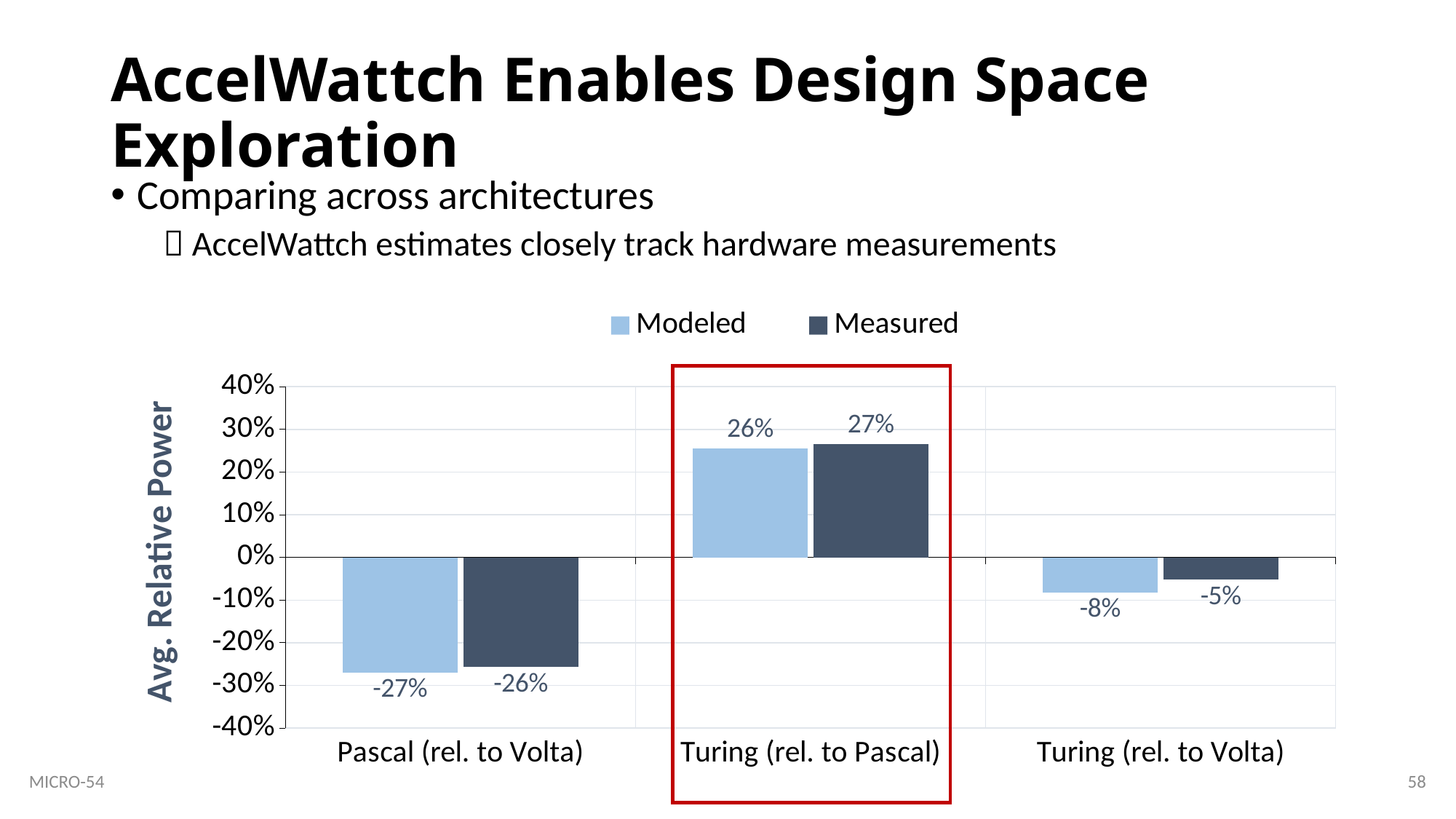
What is the label of the y axis? Avg. Relative Power How many categories are shown on the x axis? 3 What is the Measured value for Turing (rel. to Volta)? -5% What kind of chart is shown on the slide? Bar chart What is the Measured value for Turing (rel. to Pascal)? 27% Which category has the lowest Modeled value? Pascal (rel. to Volta) What is the Modeled value for Pascal (rel. to Volta)? -27% For Pascal (rel. to Volta), which is larger, the Modeled or the Measured value? Measured What is the Modeled value for Turing (rel. to Volta)? -8% Which category has the highest Measured value? Turing (rel. to Pascal) How many series does the legend list? 2 What is the difference between the Modeled and Measured values for Turing (rel. to Volta)? 3 percentage points